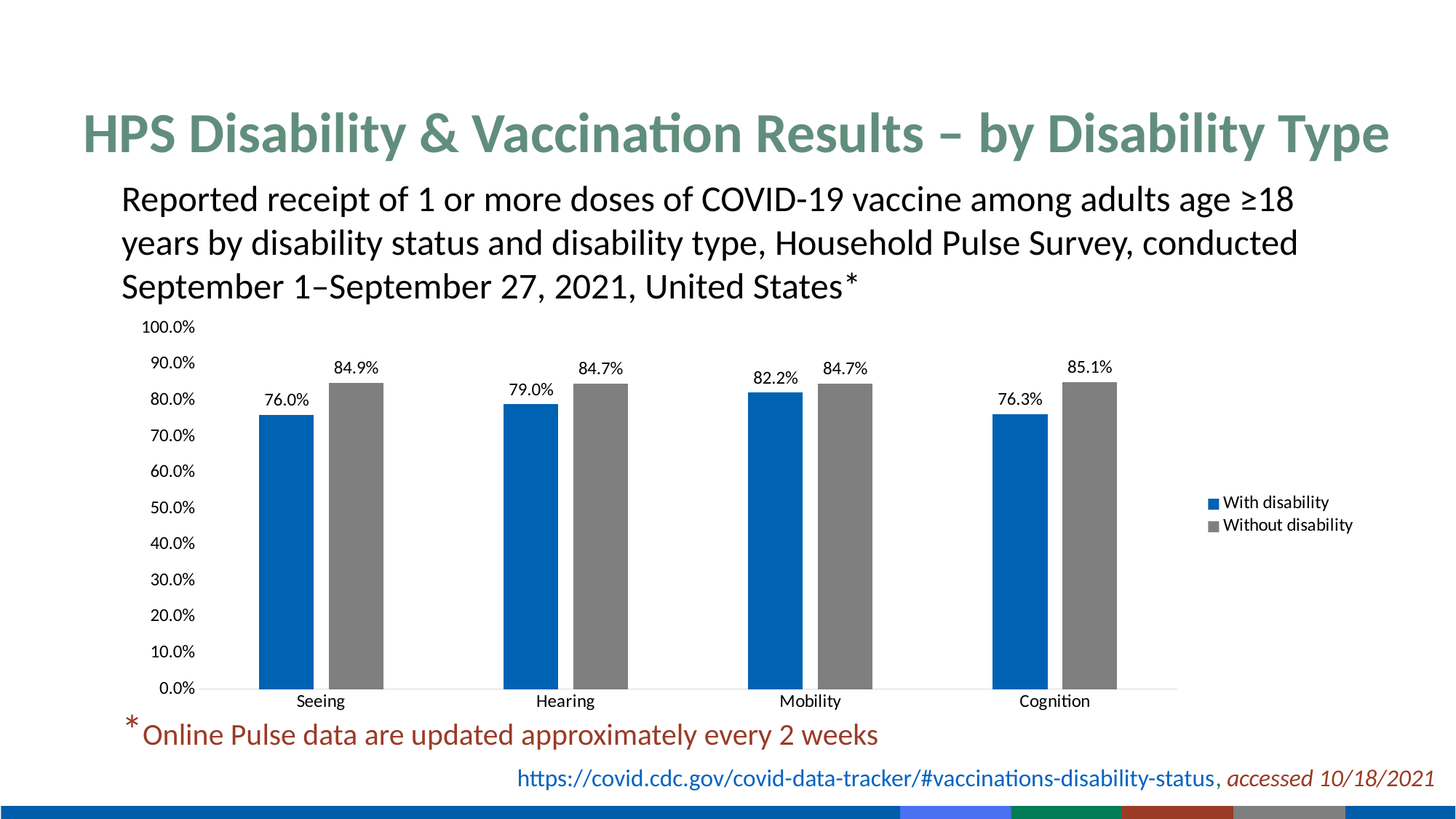
Which disability type has the lowest value in the With disability series? Seeing Is the value for Cognition in the With disability series greater or less than 80.0%? less What is the value for Mobility in the With disability series? 82.2% What is the value for Seeing in the With disability series? 76.0% What is the difference between the Without disability and With disability values for Mobility? 2.5% What kind of chart is shown on the slide? bar chart What is the value for Cognition in the Without disability series? 85.1% What is the difference between the Without disability and With disability values for Seeing? 8.9% Which disability type has the highest value in the With disability series? Mobility How many disability types are shown on the x axis? 4 How many series does the legend list? 2 For Hearing, which series has the larger value, With disability or Without disability? Without disability